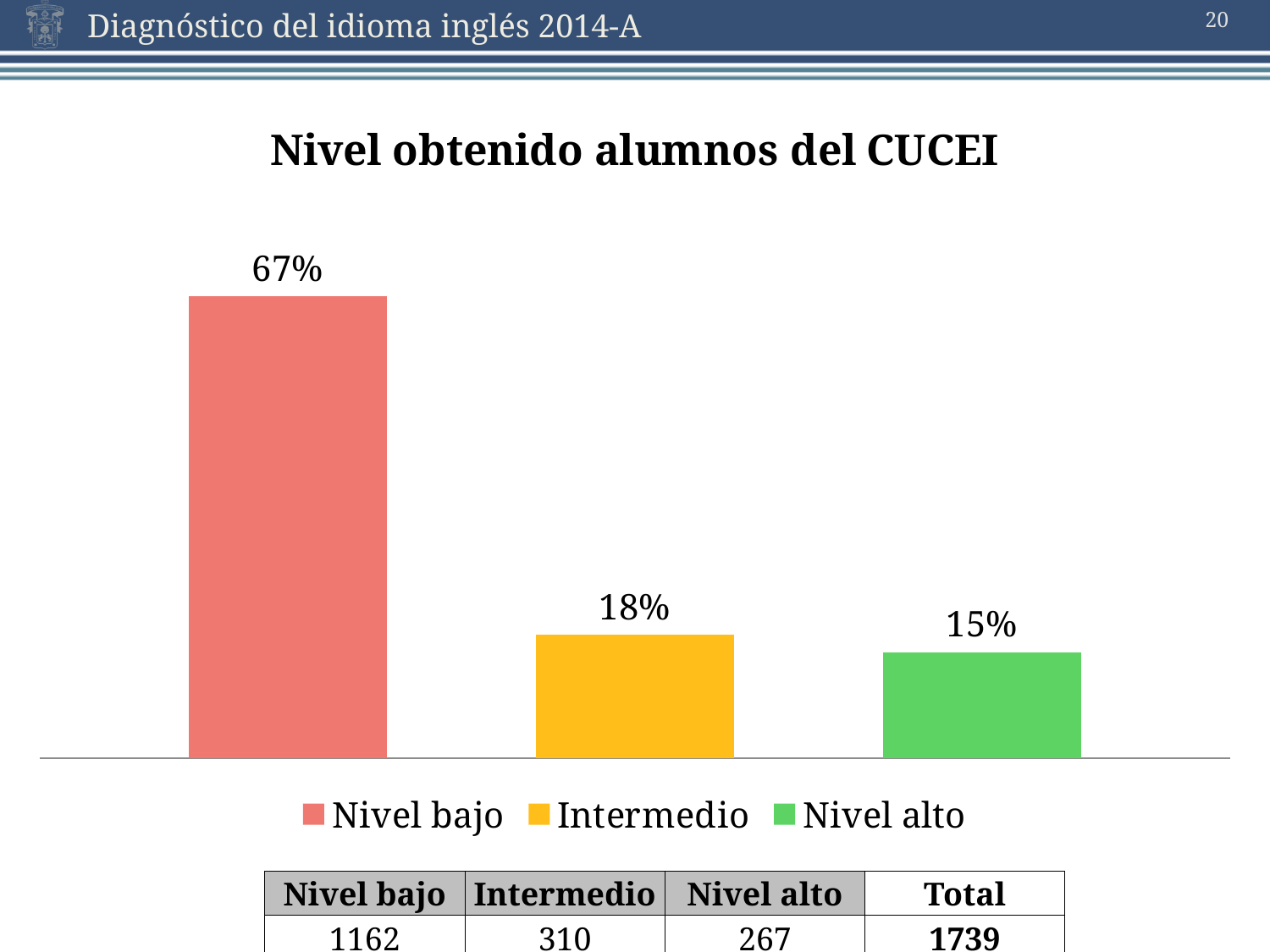
What is the title of the chart? Nivel obtenido alumnos del CUCEI What is the difference between the values for Nivel bajo and Intermedio? 49% How many entries does the legend list? 3 What is the value for Nivel alto? 15% What is the difference between the values for Intermedio and Nivel alto? 3% What kind of chart is shown on the slide? Bar chart Which is larger, the value for Intermedio or the value for Nivel alto? Intermedio How many categories are shown in the chart? 3 Which category has the lowest value? Nivel alto What is the value for Intermedio? 18% What is the value for Nivel bajo? 67% Which category has the highest value? Nivel bajo